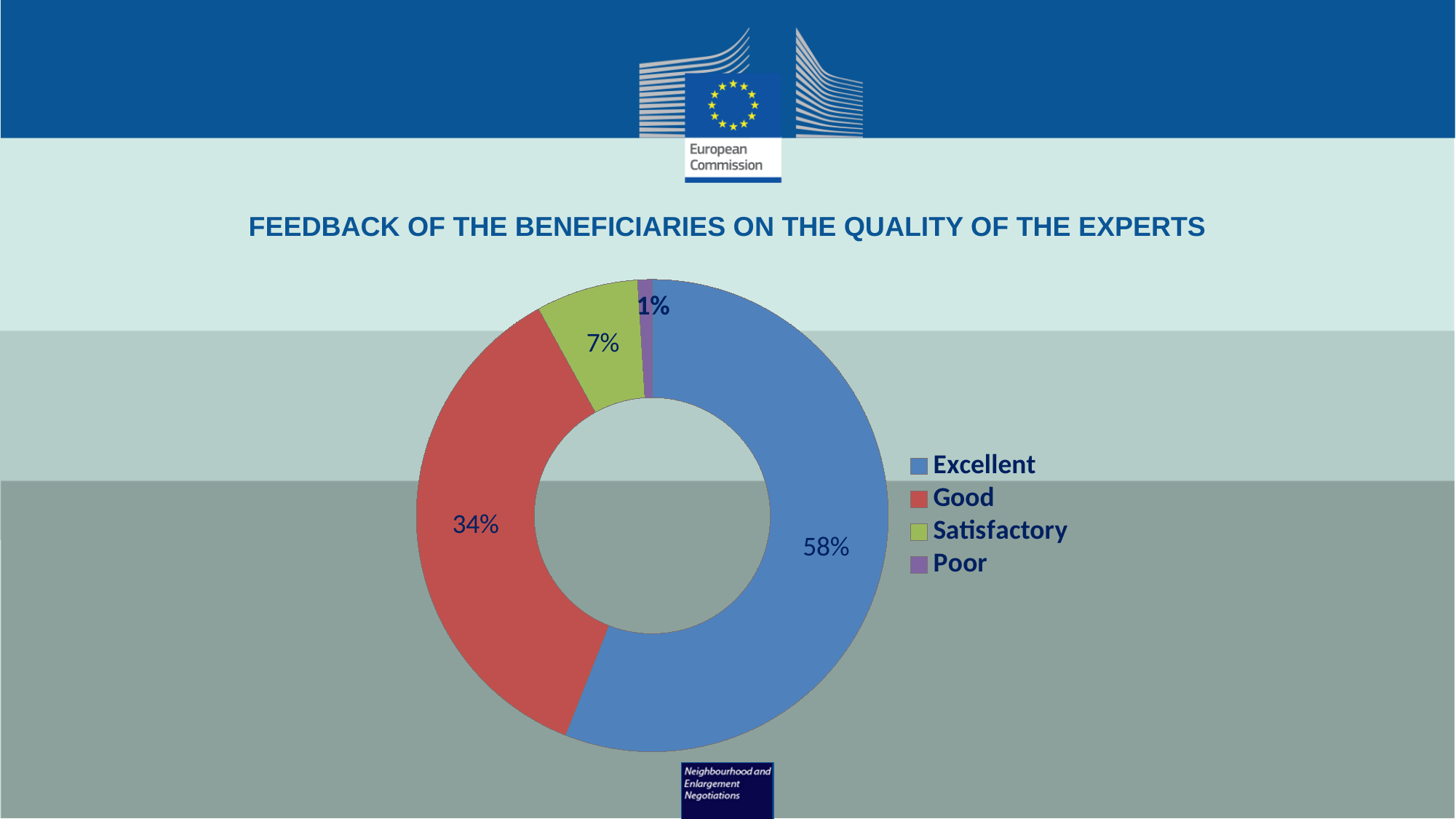
What is the difference in percentage points between the Excellent and Good shares? 24 Which colour represents the Satisfactory category in the legend? Green What percentage of beneficiaries rated the quality of the experts as Good? 34% What kind of chart is shown on the slide? Doughnut (pie) chart What percentage of beneficiaries rated the quality of the experts as Satisfactory? 7% Which share is larger, Good or Satisfactory? Good Which rating category has the smallest share of the chart? Poor What is the title of the chart? FEEDBACK OF THE BENEFICIARIES ON THE QUALITY OF THE EXPERTS Which rating category has the largest share of the chart? Excellent What percentage of beneficiaries rated the quality of the experts as Excellent? 58% What percentage of beneficiaries rated the quality of the experts as Poor? 1% How many rating categories does the chart show? 4